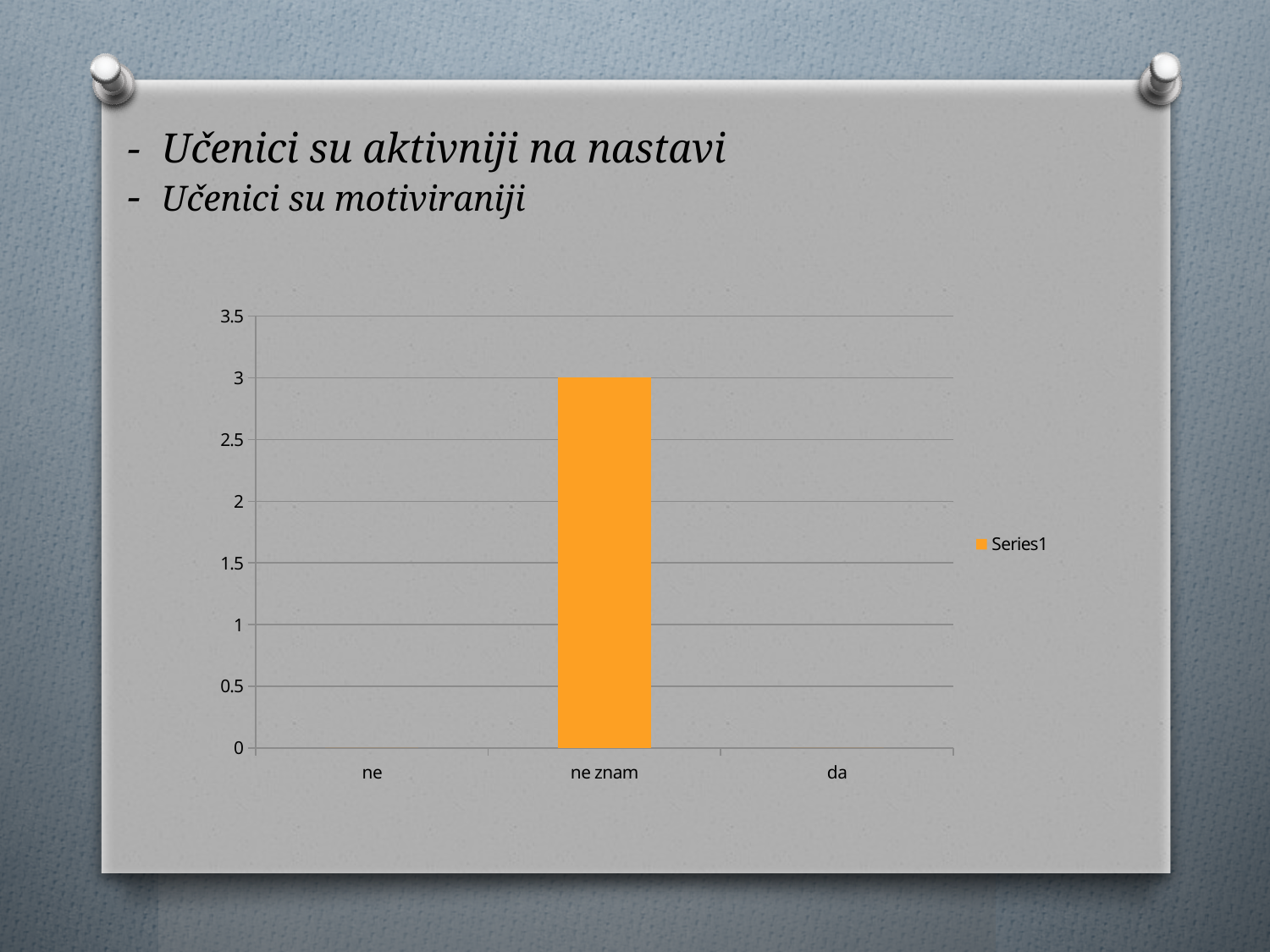
How many series does the legend list? 1 Is the value for "ne znam" greater or less than 3.5? less What colour is the bar in the chart? orange What is the name of the series shown in the legend? Series1 What kind of chart is shown on the slide? bar chart Is the value for "ne znam" greater or less than 2? greater What is the value for "ne znam"? 3 Which is larger, the value for "ne znam" or the value for "ne"? ne znam Which is larger, the value for "ne znam" or the value for "da"? ne znam What is the highest tick value shown on the y axis? 3.5 How many categories are shown on the x axis? 3 Which category has the highest value? ne znam